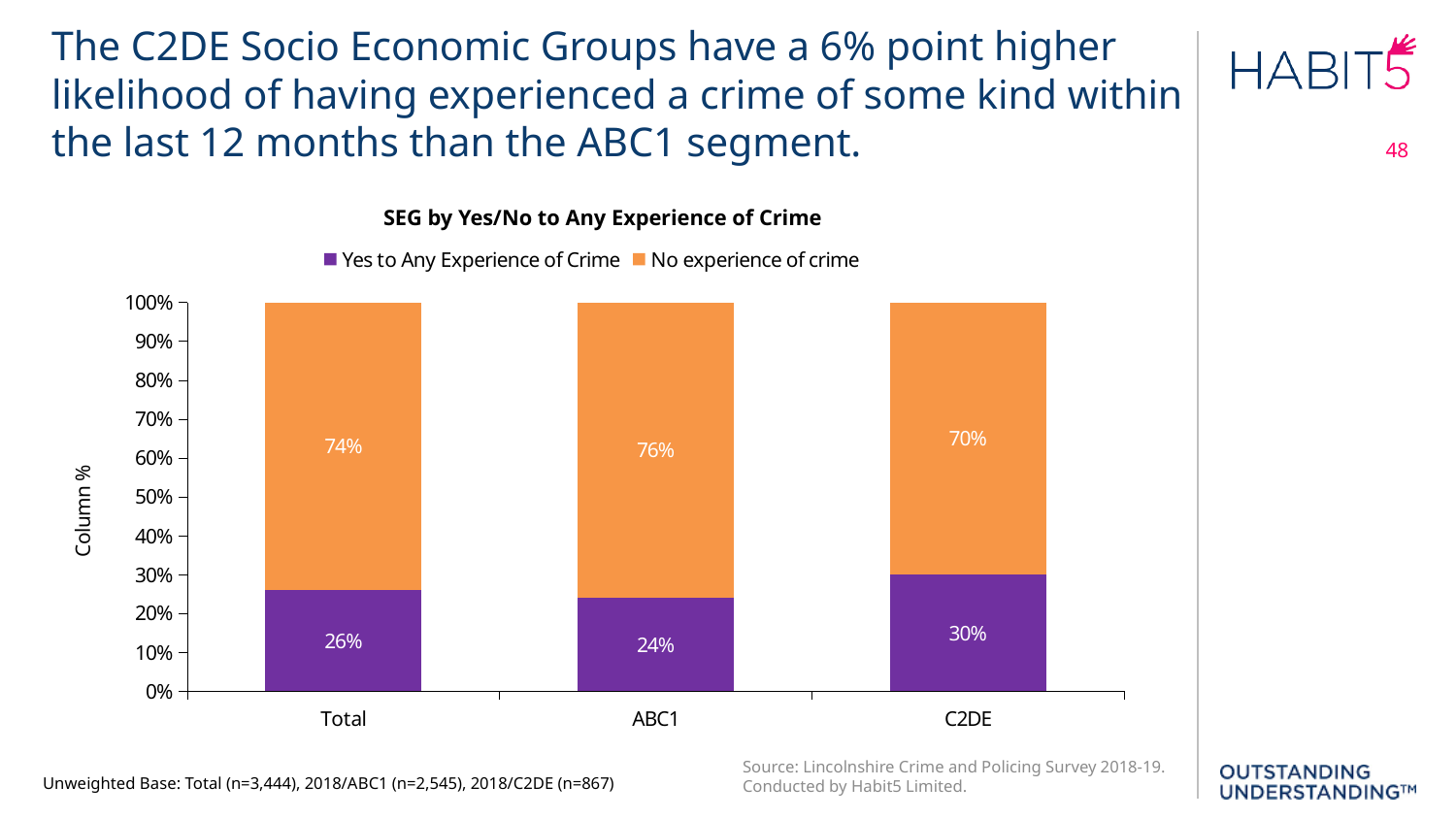
How many categories are shown on the x axis? 3 How many series does the legend list? 2 What is the total of the stacked bar for ABC1? 100% What percentage of the ABC1 group had No experience of crime? 76% What percentage of the C2DE group said Yes to Any Experience of Crime? 30% Which category has the highest value for Yes to Any Experience of Crime? C2DE What is the title of the chart? SEG by Yes/No to Any Experience of Crime What kind of chart is shown on the slide? Stacked bar chart Which is larger: the No experience of crime value for Total or for ABC1? ABC1 What is the difference in percentage points between the Yes to Any Experience of Crime values for C2DE and ABC1? 6 What is the value for Yes to Any Experience of Crime in the Total category? 26% Which category has the lowest value for No experience of crime? C2DE